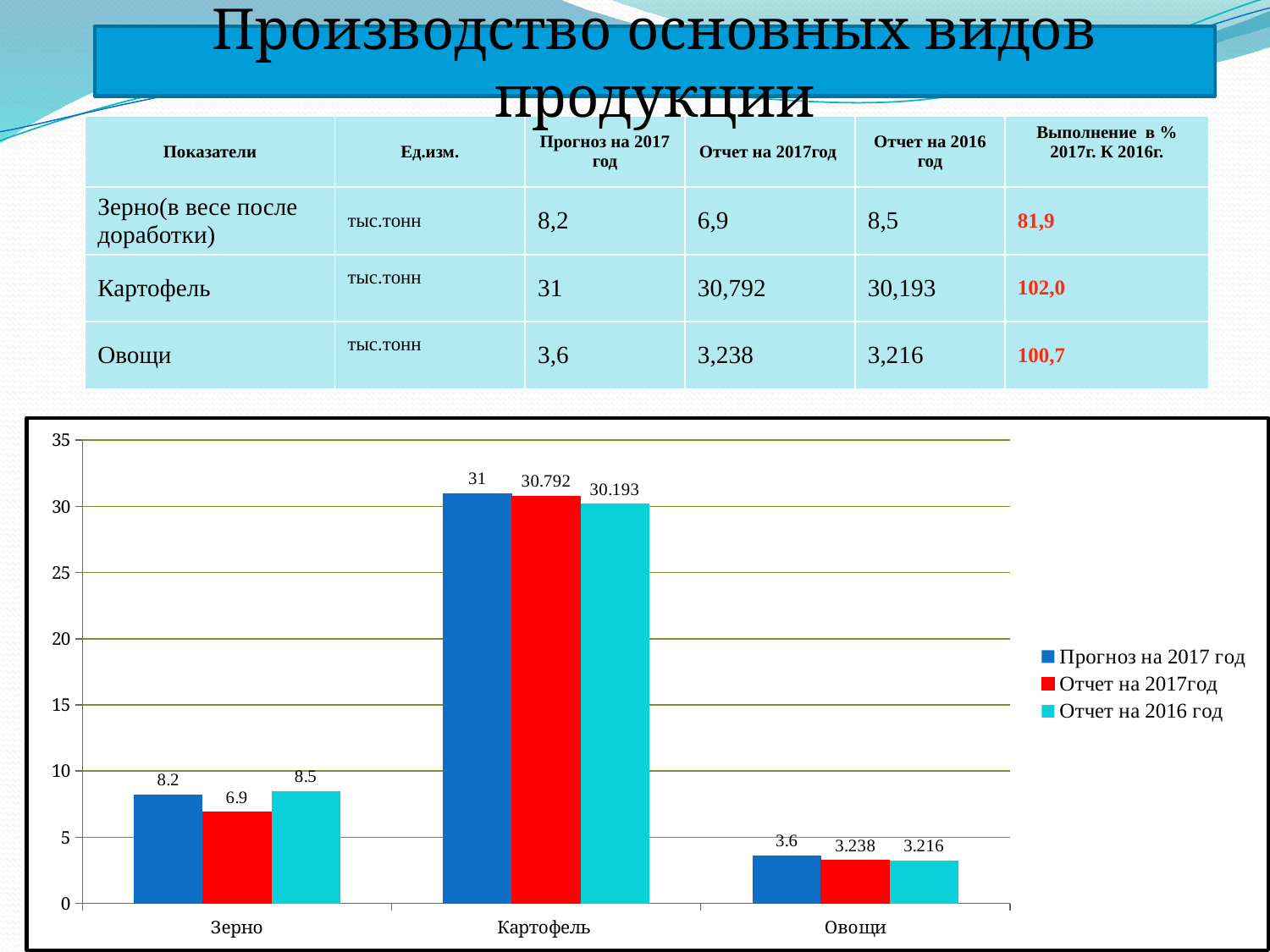
What is the value of 'Прогноз на 2017 год' for Картофель in the chart? 31 What is the value of 'Отчет на 2017год' for Зерно in the chart? 6.9 Which category has the highest values in the chart? Картофель What type of chart is shown on the slide? bar chart How many categories are shown on the x axis of the chart? 3 Which colour represents 'Отчет на 2017год' in the chart? red What is the difference between 'Отчет на 2016 год' and 'Отчет на 2017год' for Зерно? 1.6 For Зерно, which is larger: 'Прогноз на 2017 год' or 'Отчет на 2017год'? Прогноз на 2017 год How many series does the chart legend list? 3 Is the value of 'Отчет на 2017год' for Картофель greater or less than 25? greater Which category has the lowest values in the chart? Овощи What is the value of 'Отчет на 2016 год' for Овощи in the chart? 3.216